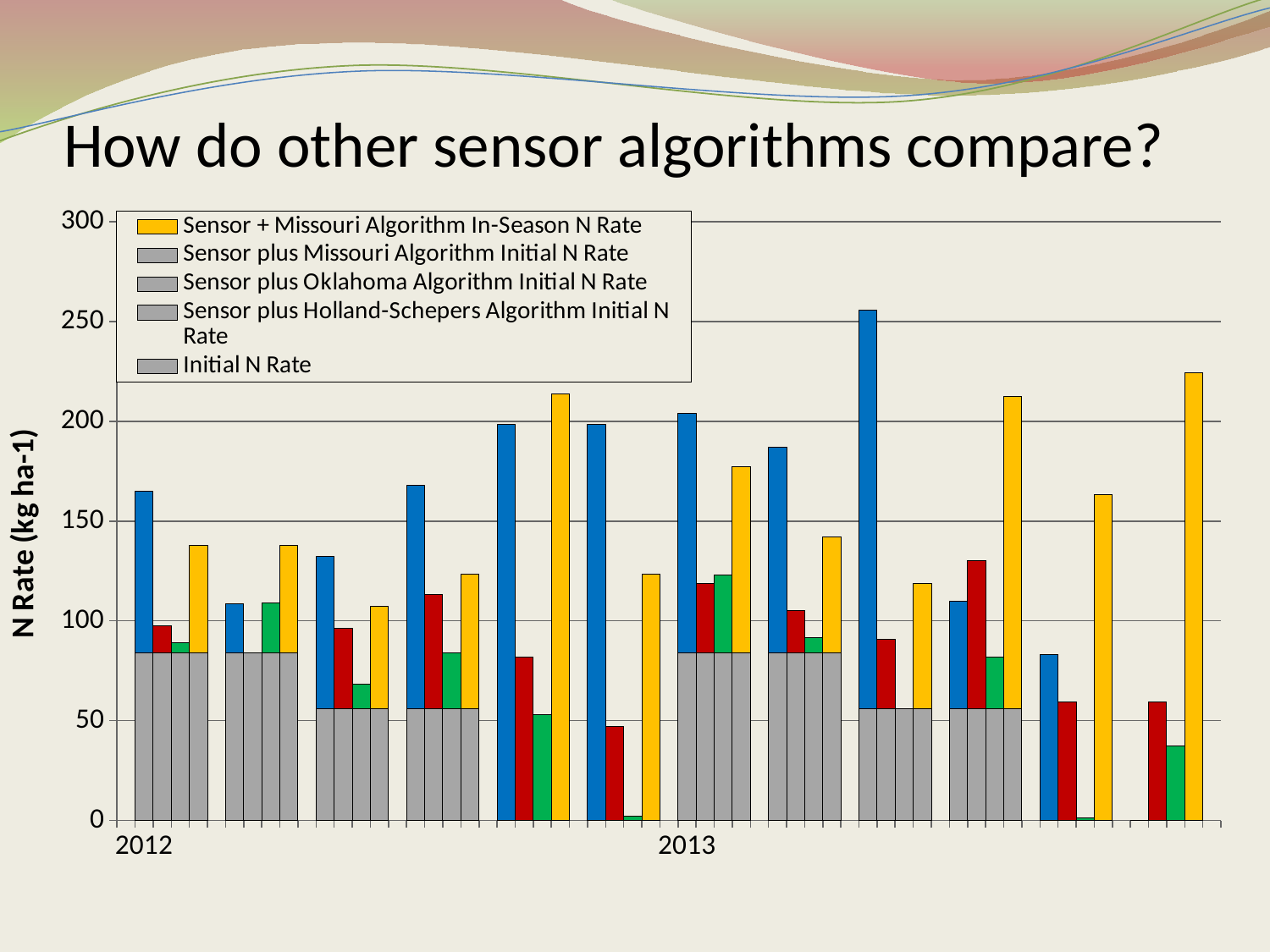
What is the title of the slide? How do other sensor algorithms compare? What is the label on the y axis? N Rate (kg ha-1) How many series does the legend list? 5 What kind of chart is shown on the slide? bar chart Is the tallest bar in the 2012 group greater or less than 250? less How many years are labelled on the x axis? 2 Which year group contains the tallest bar in the chart, 2012 or 2013? 2013 Is the tallest bar in the chart greater or less than 300? less Is the tallest yellow bar in the chart greater or less than 250? less